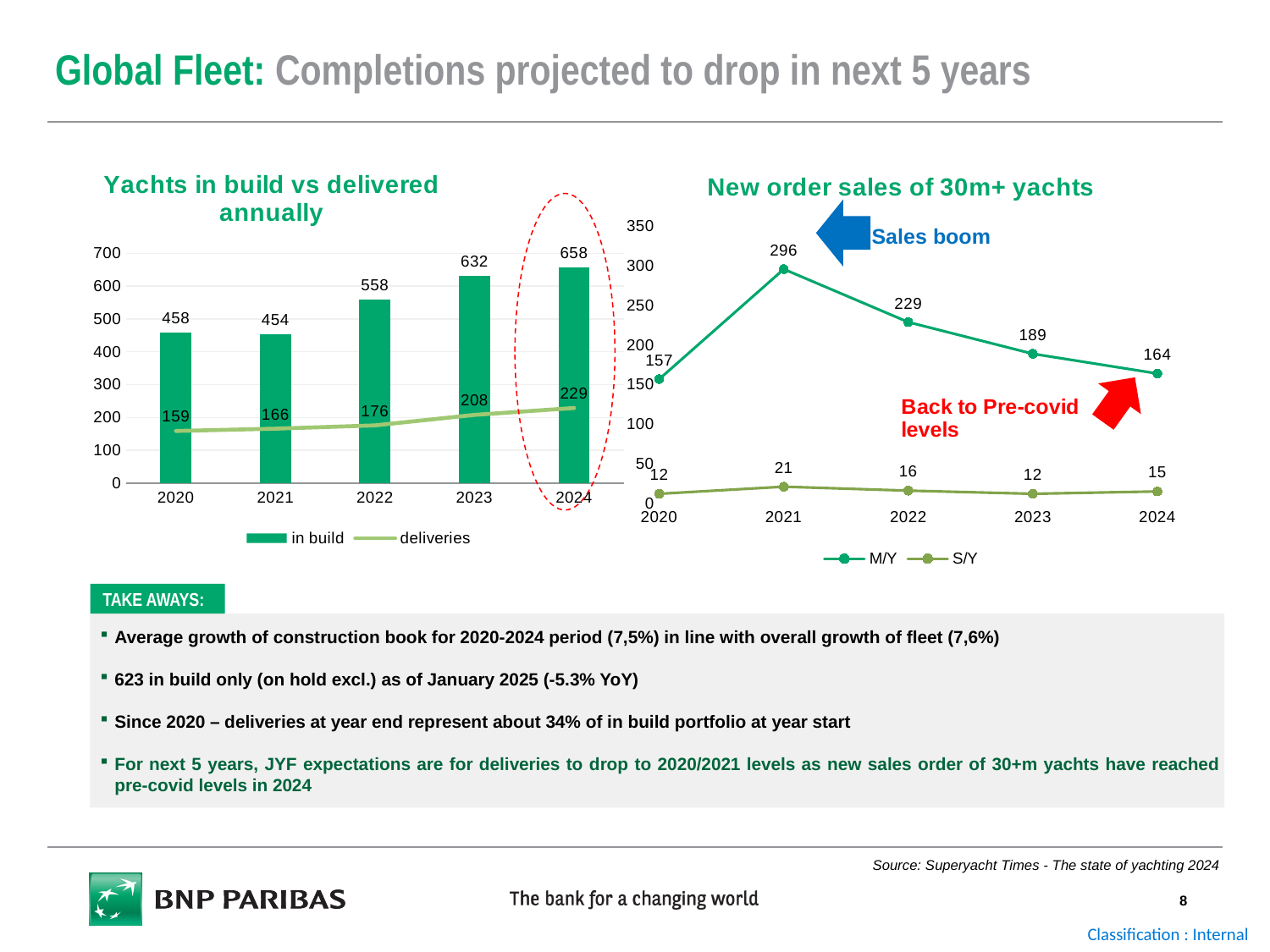
In the 'Yachts in build vs delivered annually' chart, which year has the lowest 'deliveries' value? 2020 In the 'New order sales of 30m+ yachts' chart, what is the difference between the M/Y values for 2021 and 2024? 132 In the 'Yachts in build vs delivered annually' chart, how many series does the legend list? 2 In the 'Yachts in build vs delivered annually' chart, which year has the highest 'in build' value? 2024 In the 'Yachts in build vs delivered annually' chart, what is the 'deliveries' value for 2023? 208 In the 'New order sales of 30m+ yachts' chart, what is the M/Y value for 2021? 296 In the 'Yachts in build vs delivered annually' chart, what is the 'in build' value for 2022? 558 In the 'New order sales of 30m+ yachts' chart, which year has the highest S/Y value? 2021 In the 'New order sales of 30m+ yachts' chart, what is the S/Y value for 2024? 15 What kind of chart is 'New order sales of 30m+ yachts'? line chart In the 'New order sales of 30m+ yachts' chart, do the M/Y values rise or fall from 2021 to 2024? fall In the 'Yachts in build vs delivered annually' chart, what is the difference between the 'in build' values for 2024 and 2020? 200